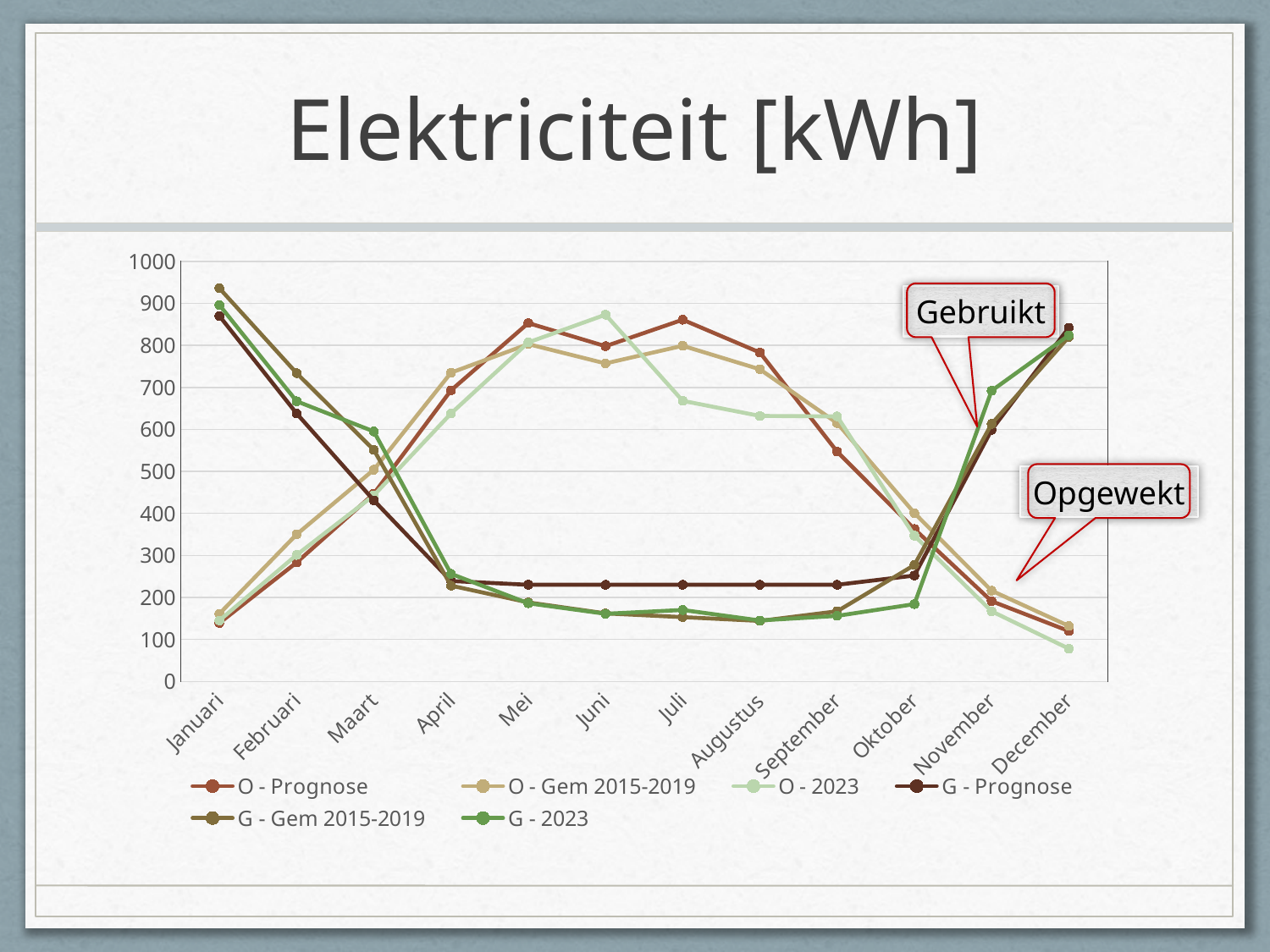
What is the title of the chart? Elektriciteit [kWh] In which month does the O - 2023 series reach its highest value? Juni In Juni, which is larger: O - 2023 or O - Prognose? O - 2023 How many months are shown along the x axis? 12 Is the value for G - 2023 in Januari greater or less than 800? greater Is the value for O - 2023 in December greater or less than 100? less Is the value for G - Prognose in Mei greater or less than 300? less In which month does the O - 2023 series reach its lowest value? December What kind of chart is shown on the slide? line chart How many series does the legend list? 6 What are the two callout labels pointing at the lines on the right side of the chart? Gebruikt and Opgewekt